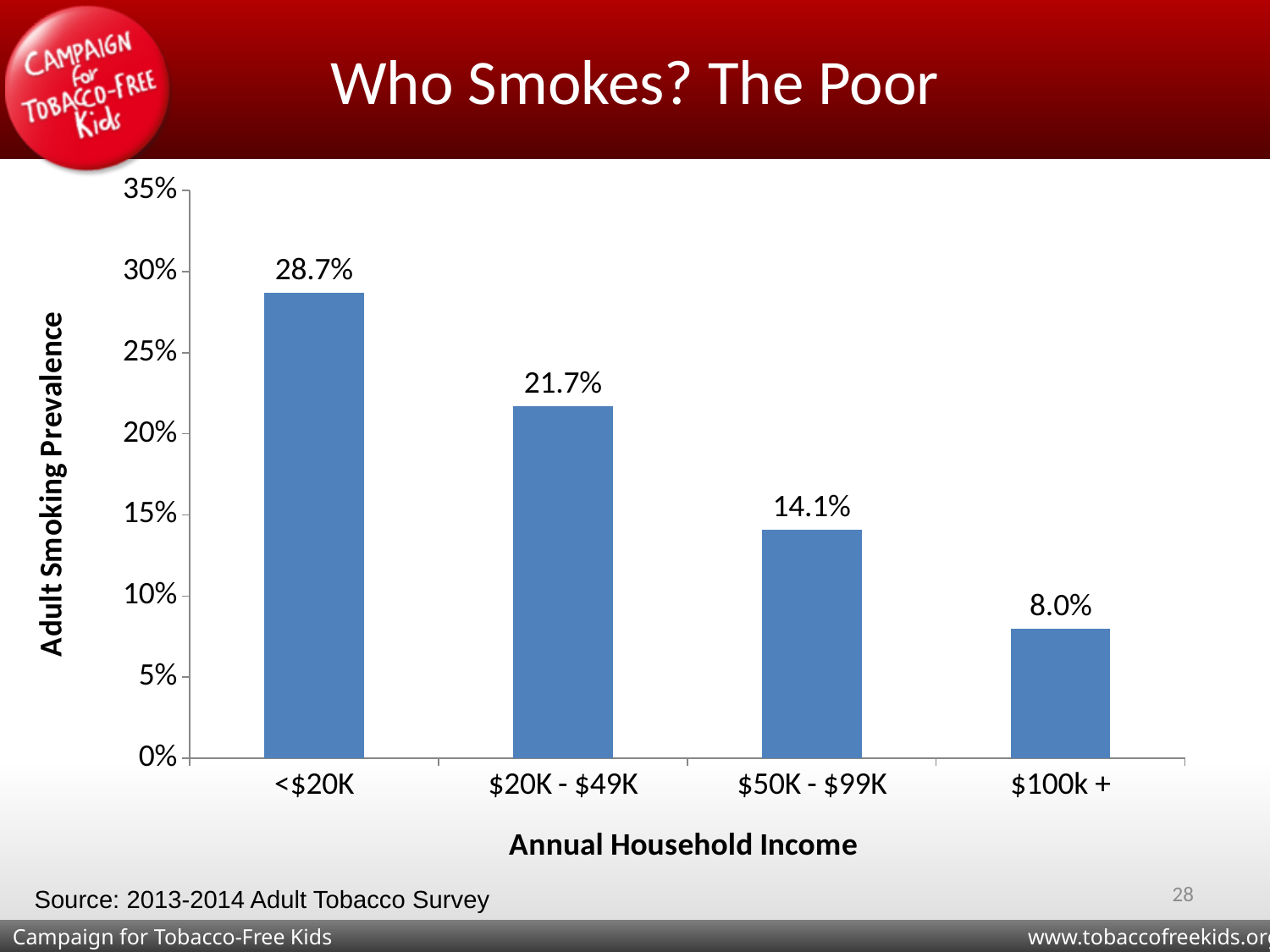
Which has a higher smoking prevalence, the $20K - $49K group or the $50K - $99K group? $20K - $49K What is the label of the y axis? Adult Smoking Prevalence What is the adult smoking prevalence for the $50K - $99K income group? 14.1% Which income group has the highest adult smoking prevalence? <$20K What is the adult smoking prevalence for the $20K - $49K income group? 21.7% What type of chart is shown on the slide? Bar chart How many income categories are shown in the chart? 4 What is the adult smoking prevalence for households earning less than $20K? 28.7% What is the adult smoking prevalence for households earning $100k or more? 8.0% Which income group has the lowest adult smoking prevalence? $100k + How does adult smoking prevalence change as annual household income increases along the x axis? It falls What is the difference in smoking prevalence between the <$20K group and the $100k + group? 20.7%